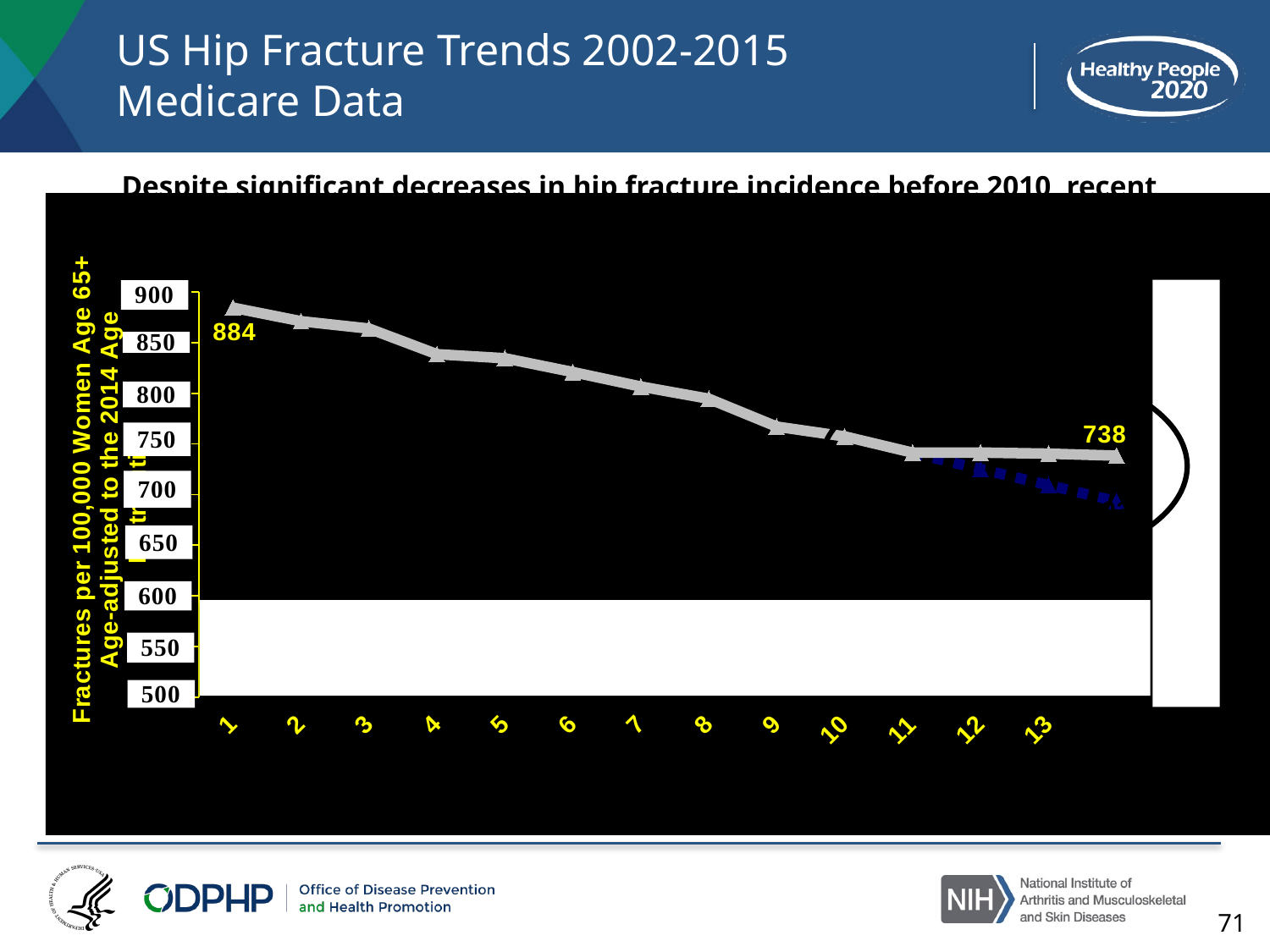
Is the value at point 2 greater or less than 850? greater Which point has the highest value on the line chart? 1 Which is larger, the value at point 3 or the value at point 9? Point 3 What is the value labelled at point 1 on the line chart? 884 Do the values rise or fall from point 1 to point 13 along the x axis? fall Is the value at point 6 greater or less than 800? greater Which is larger, the value at point 1 or the value at point 13? Point 1 What kind of chart is shown on the slide? line chart Is the value at point 11 greater or less than 750? less How many points are labelled on the x axis of the chart? 13